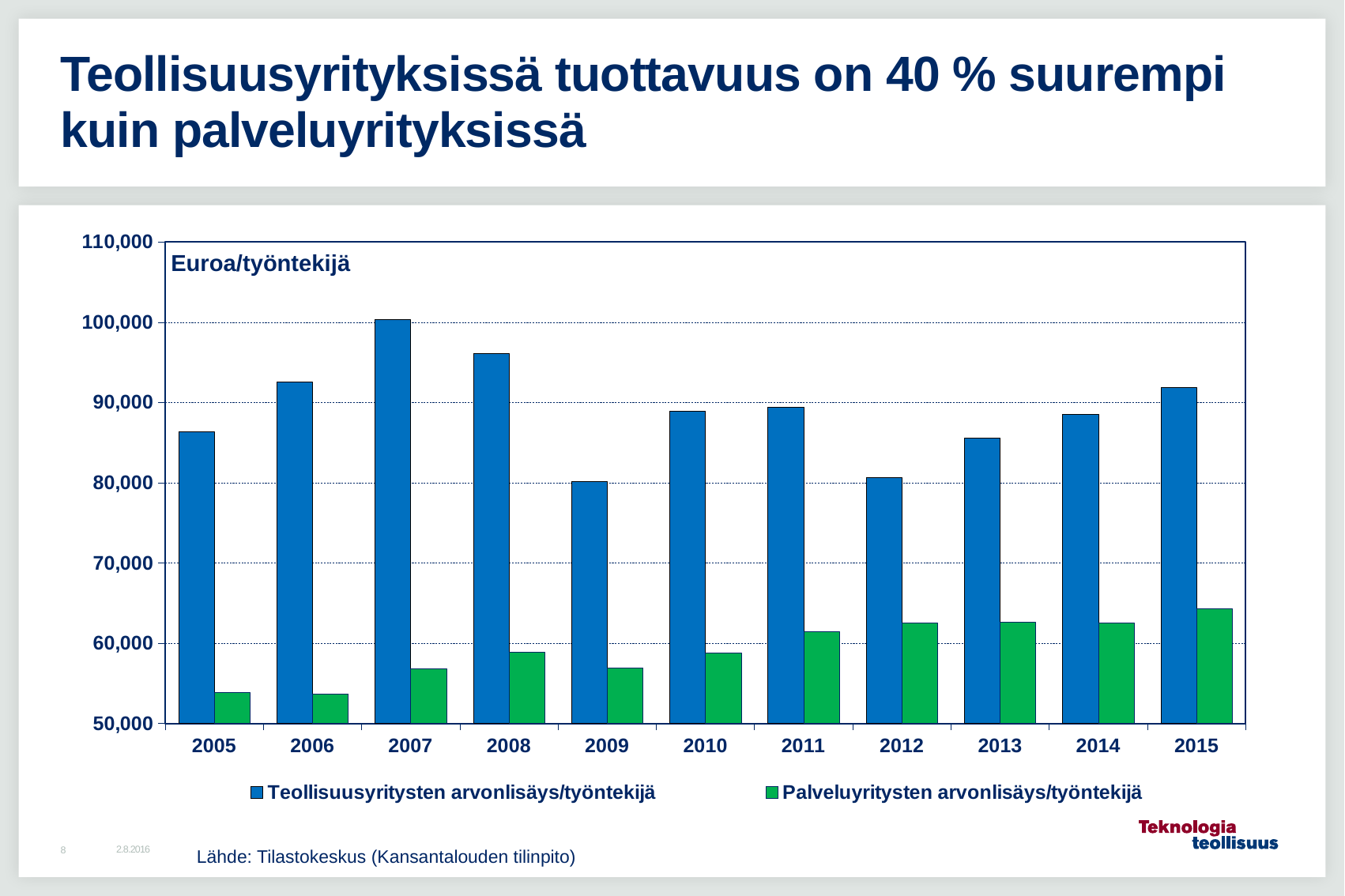
In which year is Palveluyritysten arvonlisäys/työntekijä highest? 2015 Is the value for Teollisuusyritysten arvonlisäys/työntekijä in 2008 greater or less than 90,000? greater Which is larger: Palveluyritysten arvonlisäys/työntekijä in 2012 or in 2010? 2012 Is the value for Palveluyritysten arvonlisäys/työntekijä in 2005 greater or less than 60,000? less How many series does the legend list? 2 Is the value for Palveluyritysten arvonlisäys/työntekijä in 2015 greater or less than 60,000? greater How many years are shown on the x axis? 11 In which year is Teollisuusyritysten arvonlisäys/työntekijä highest? 2007 Which is larger: Teollisuusyritysten arvonlisäys/työntekijä in 2007 or in 2008? 2007 What kind of chart is shown on the slide? bar chart What unit label is printed inside the top left of the plot area? Euroa/työntekijä